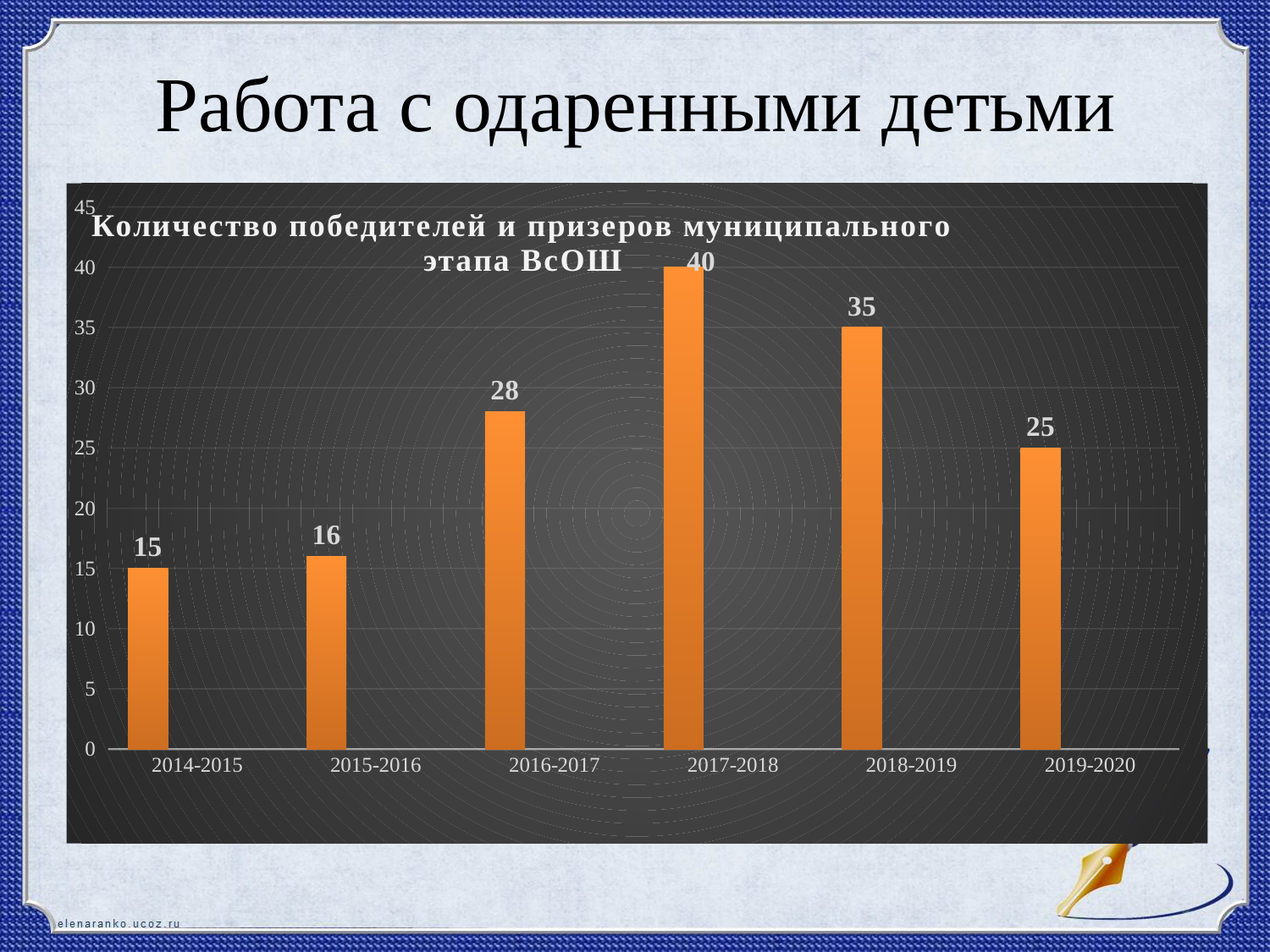
How many categories are shown on the x axis? 6 What is the value for 2017-2018? 40 What is the difference between the values for 2017-2018 and 2018-2019? 5 What kind of chart is shown on the slide? bar chart What is the value for 2014-2015? 15 Which year has the lowest value? 2014-2015 Which year has the highest value? 2017-2018 What is the value for 2019-2020? 25 What is the difference between the values for 2016-2017 and 2015-2016? 12 Which is larger, the value for 2018-2019 or the value for 2019-2020? 2018-2019 What is the title of the chart? Количество победителей и призеров муниципального этапа ВсОШ Is the value for 2016-2017 greater or less than 30? less